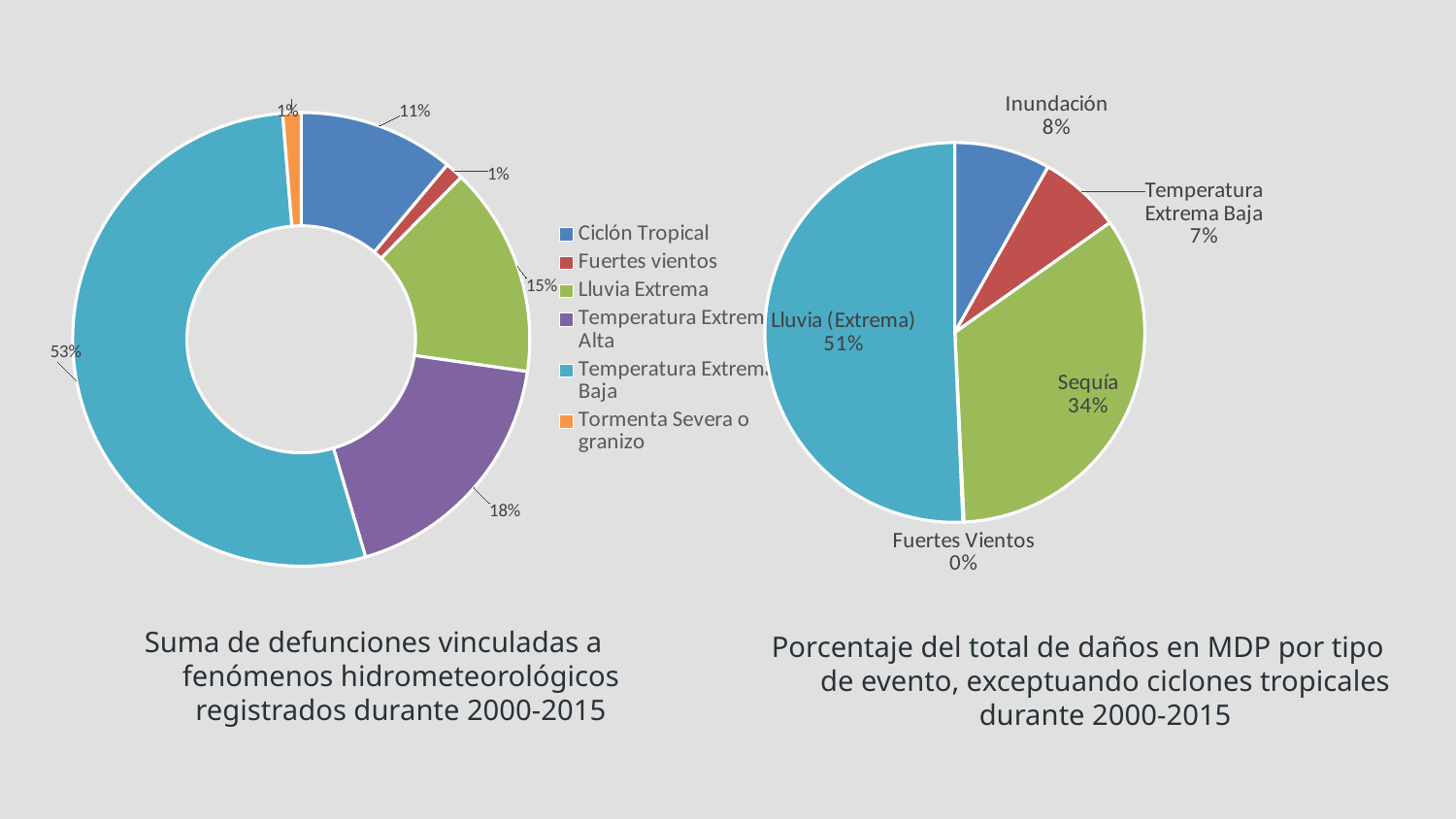
In the left doughnut chart, which category has the largest share? Temperatura Extrema Baja In the left doughnut chart, what percentage is shown for Temperatura Extrema Alta? 18% In the left doughnut chart, what percentage is shown for Ciclón Tropical? 11% In the right pie chart, which category has the smallest share? Fuertes Vientos In the right pie chart, what percentage is shown for Sequía? 34% What type of chart is the chart on the right of the slide? Pie chart In the right pie chart, which is larger, Lluvia (Extrema) or Sequía? Lluvia (Extrema) In the left doughnut chart, how many categories does the legend list? 6 In the left doughnut chart, what is the difference between the shares of Temperatura Extrema Alta and Lluvia Extrema? 3% In the right pie chart, what percentage is shown for Inundación? 8% In the left doughnut chart, what percentage is shown for Temperatura Extrema Baja? 53% In the right pie chart, what is the difference between the shares of Inundación and Temperatura Extrema Baja? 1%